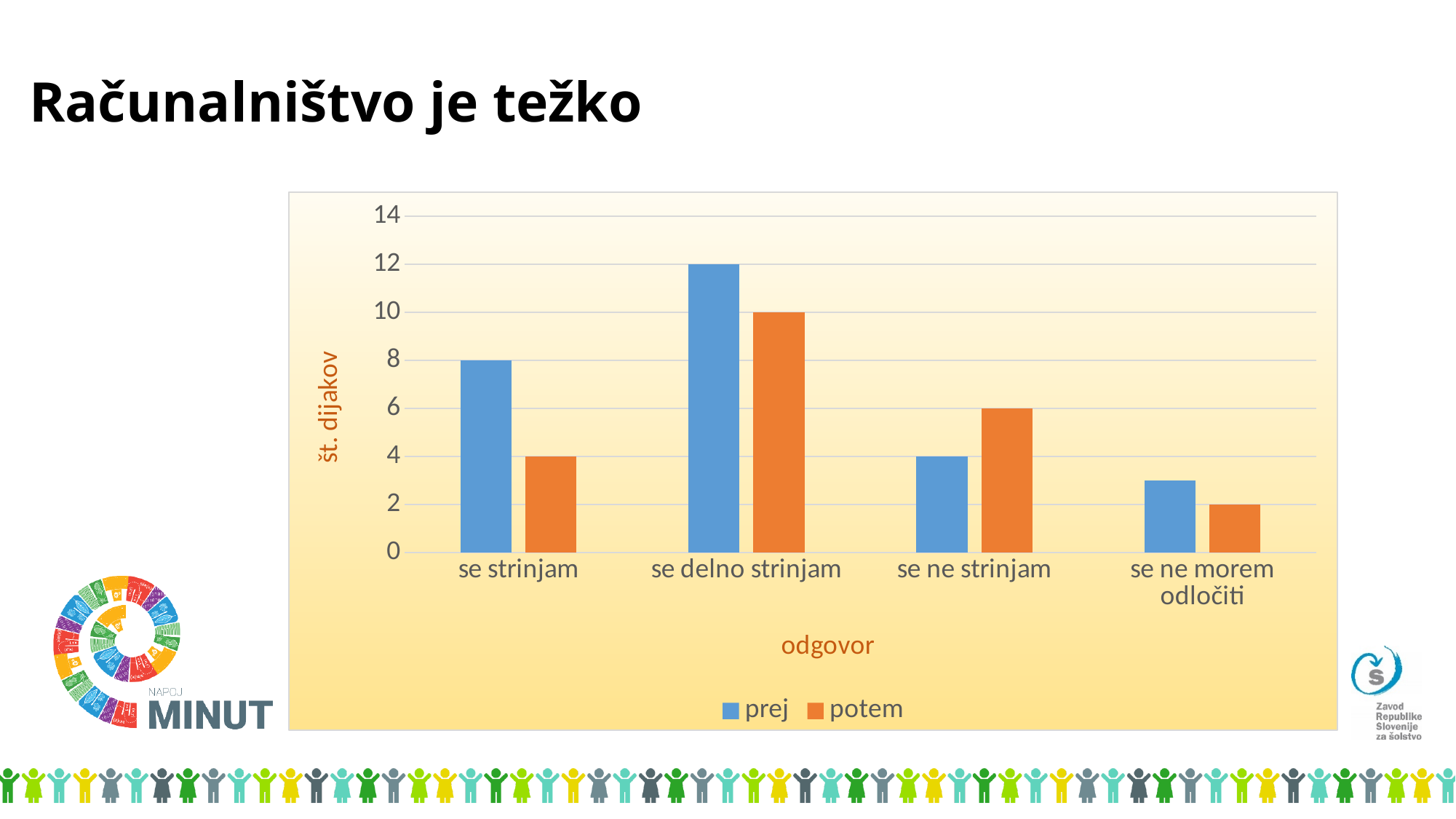
What is the value of the 'potem' series for 'se ne strinjam'? 6 What is the label of the y axis? št. dijakov What is the difference between the 'prej' and 'potem' values for 'se strinjam'? 4 How many categories are shown on the x axis? 4 What kind of chart is shown on the slide? bar chart Is the 'prej' value for 'se ne morem odločiti' greater or less than 4? less For 'se ne strinjam', which series has the larger value, 'prej' or 'potem'? potem Which category has the lowest value in the 'prej' series? se ne morem odločiti Which category has the highest value in the 'potem' series? se delno strinjam What is the value of the 'prej' series for 'se strinjam'? 8 How many series does the legend list? 2 What is the value of the 'prej' series for 'se delno strinjam'? 12